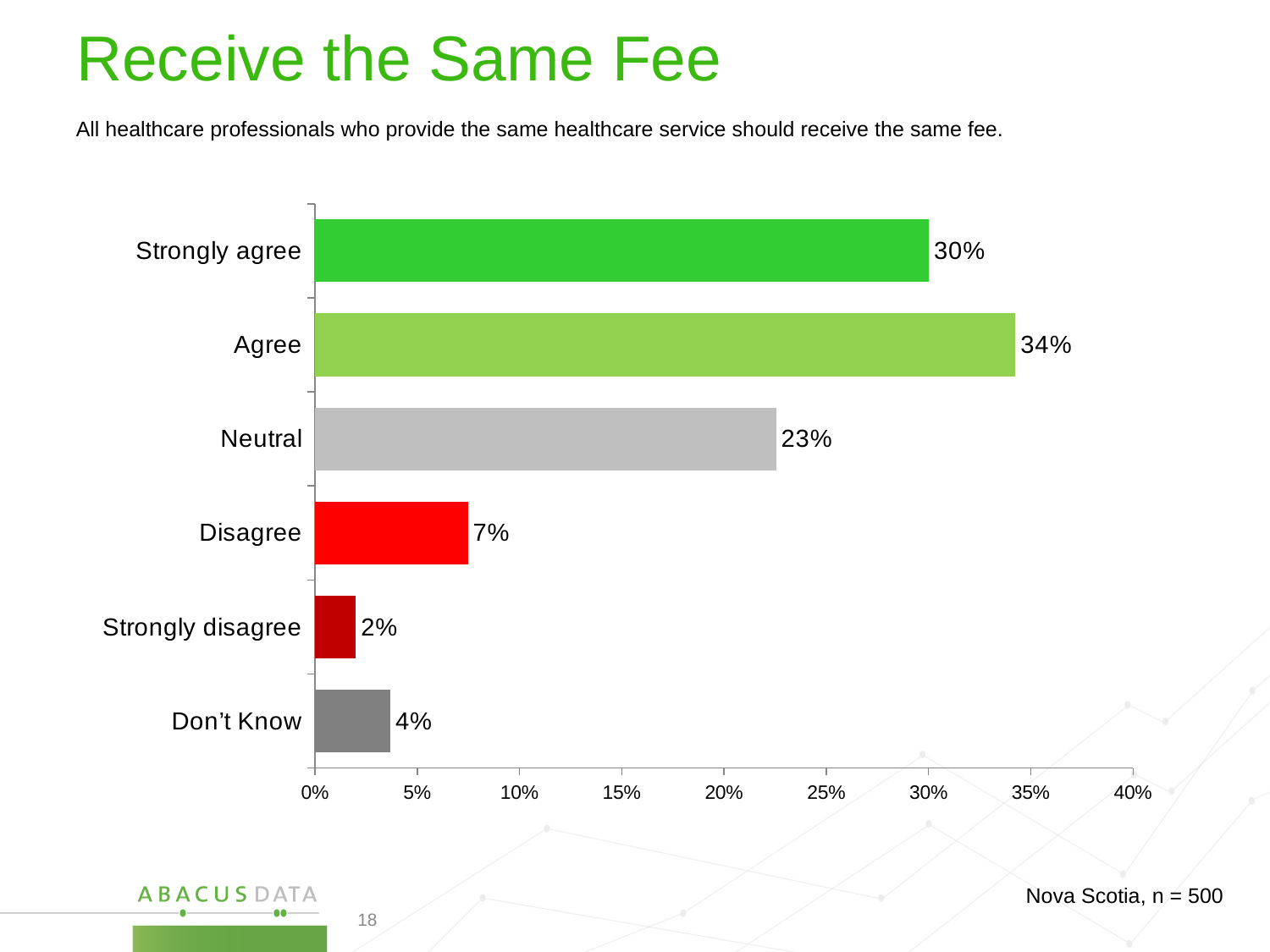
Which response category has the lowest value? Strongly disagree Which is larger, the value for Neutral or the value for Disagree? Neutral What percentage of respondents strongly agree? 30% Which response category has the highest value? Agree What is the value for Neutral? 23% What kind of chart is shown on the slide? Bar chart What is the difference between the Disagree and Strongly disagree values? 5% How many response categories are shown in the chart? 6 Is the value for Agree greater or less than 30%? greater What is the title of the slide? Receive the Same Fee What is the difference between the Agree and Strongly agree values? 4% What percentage of respondents answered Don't Know? 4%